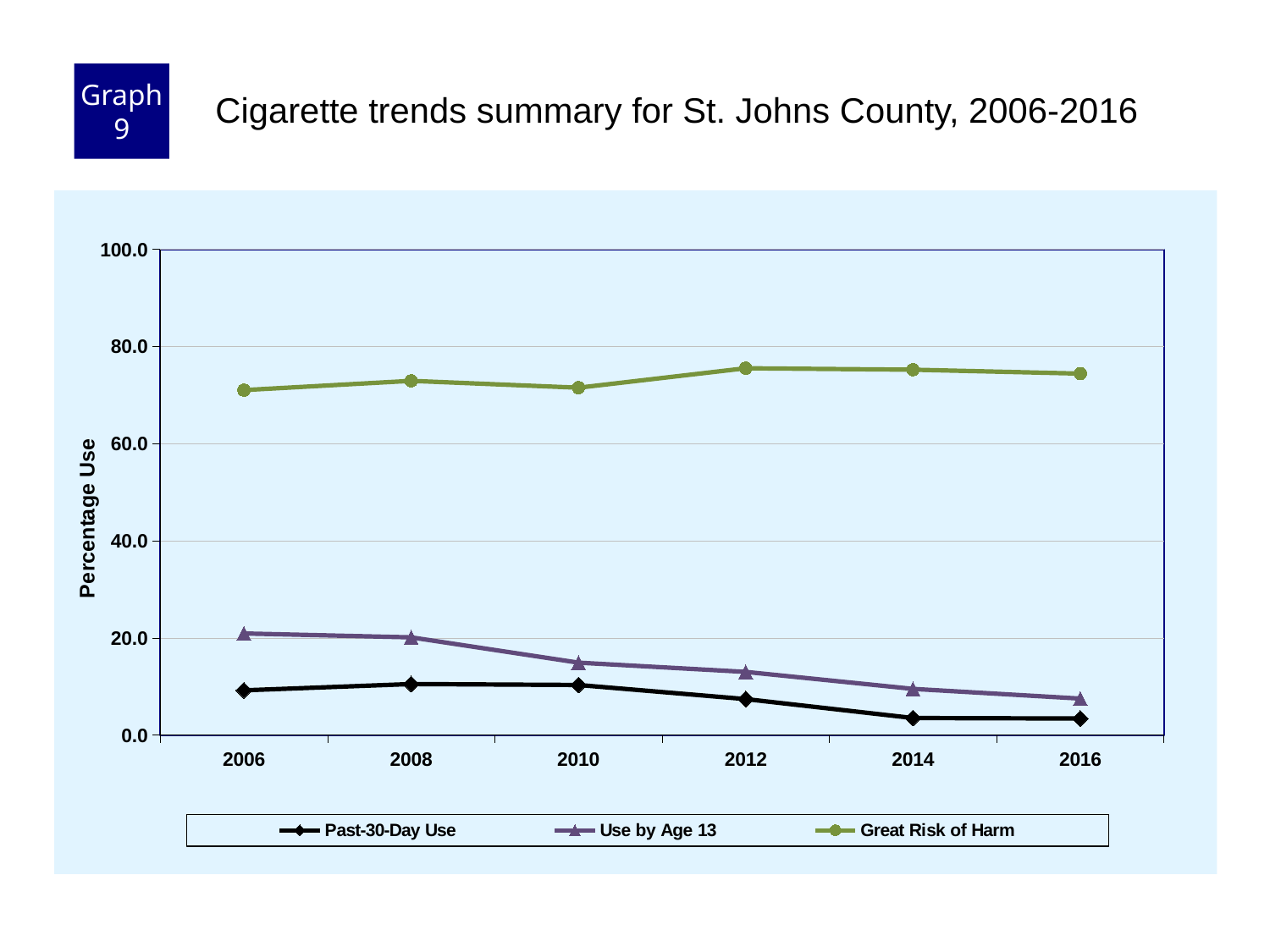
In which year is Use by Age 13 at its lowest? 2016 Which series has the highest values across all years? Great Risk of Harm Is the value for Use by Age 13 in 2016 greater or less than 20.0? less How many years are plotted along the x axis? 6 Is the value for Past-30-Day Use in 2014 greater or less than 20.0? less What kind of chart is shown on the slide? Line chart What is the label on the y axis? Percentage Use Which is larger, Past-30-Day Use in 2006 or Past-30-Day Use in 2016? 2006 How many series does the legend list? 3 Is the value for Great Risk of Harm in 2006 greater or less than 80.0? less Does the Use by Age 13 series rise or fall from 2006 to 2016? Fall